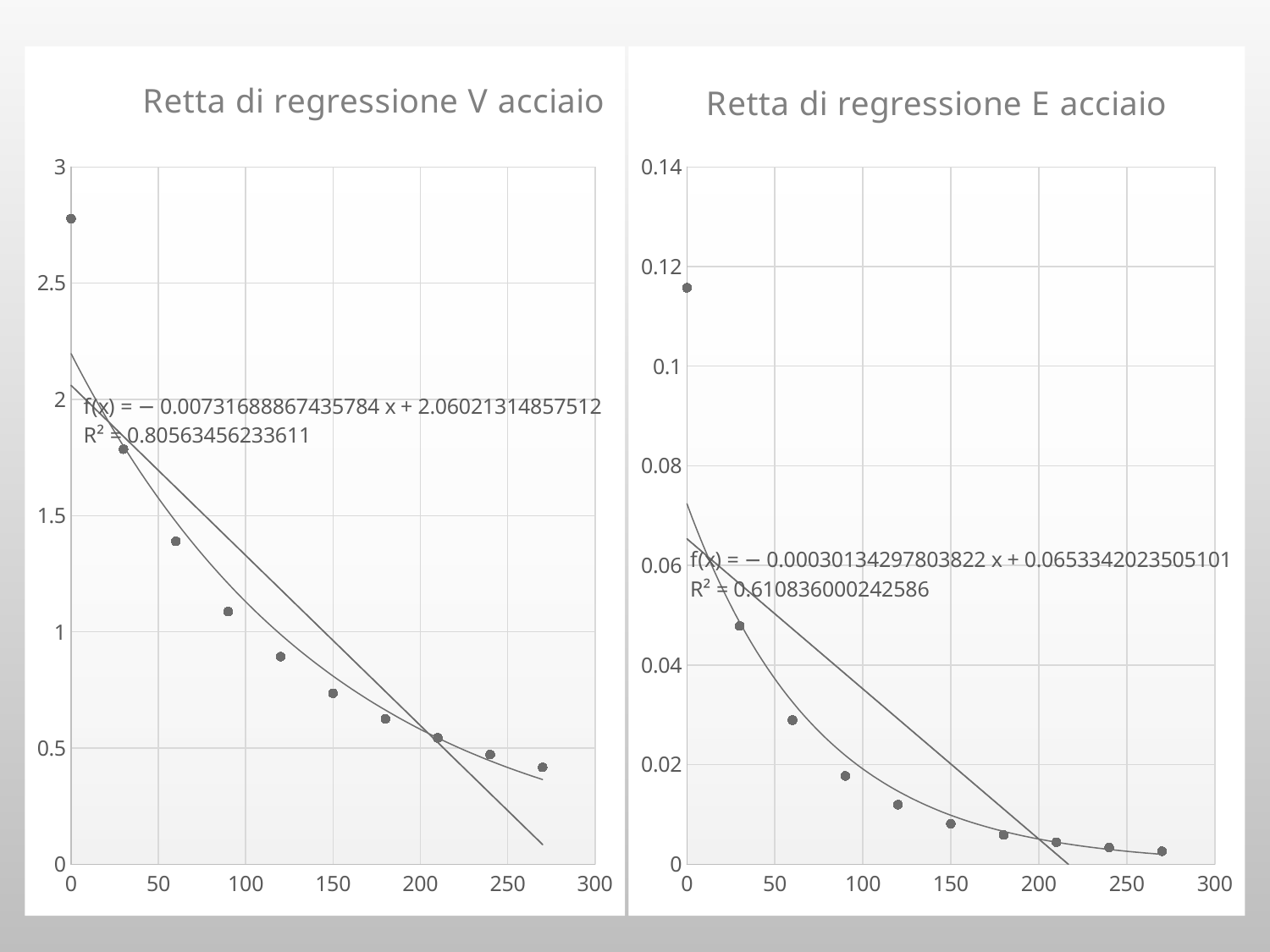
How many data points are plotted in the chart 'Retta di regressione E acciaio'? 10 How many data points are plotted in the chart 'Retta di regressione V acciaio'? 10 In the chart 'Retta di regressione V acciaio', at which x value is the plotted point highest? 0 What R² value is printed on the chart 'Retta di regressione V acciaio'? 0.80563456233611 In the chart 'Retta di regressione V acciaio', is the value at x = 270 greater or less than 0.5? less In the chart 'Retta di regressione V acciaio', do the plotted values rise or fall as x increases? fall In the chart 'Retta di regressione E acciaio', at which x value is the plotted point lowest? 270 In the chart 'Retta di regressione V acciaio', is the value at x = 0 greater or less than 2.5? greater What kind of chart is 'Retta di regressione V acciaio'? scatter chart In the chart 'Retta di regressione E acciaio', do the plotted values rise or fall as x increases? fall In the chart 'Retta di regressione E acciaio', is the value at x = 270 greater or less than 0.02? less